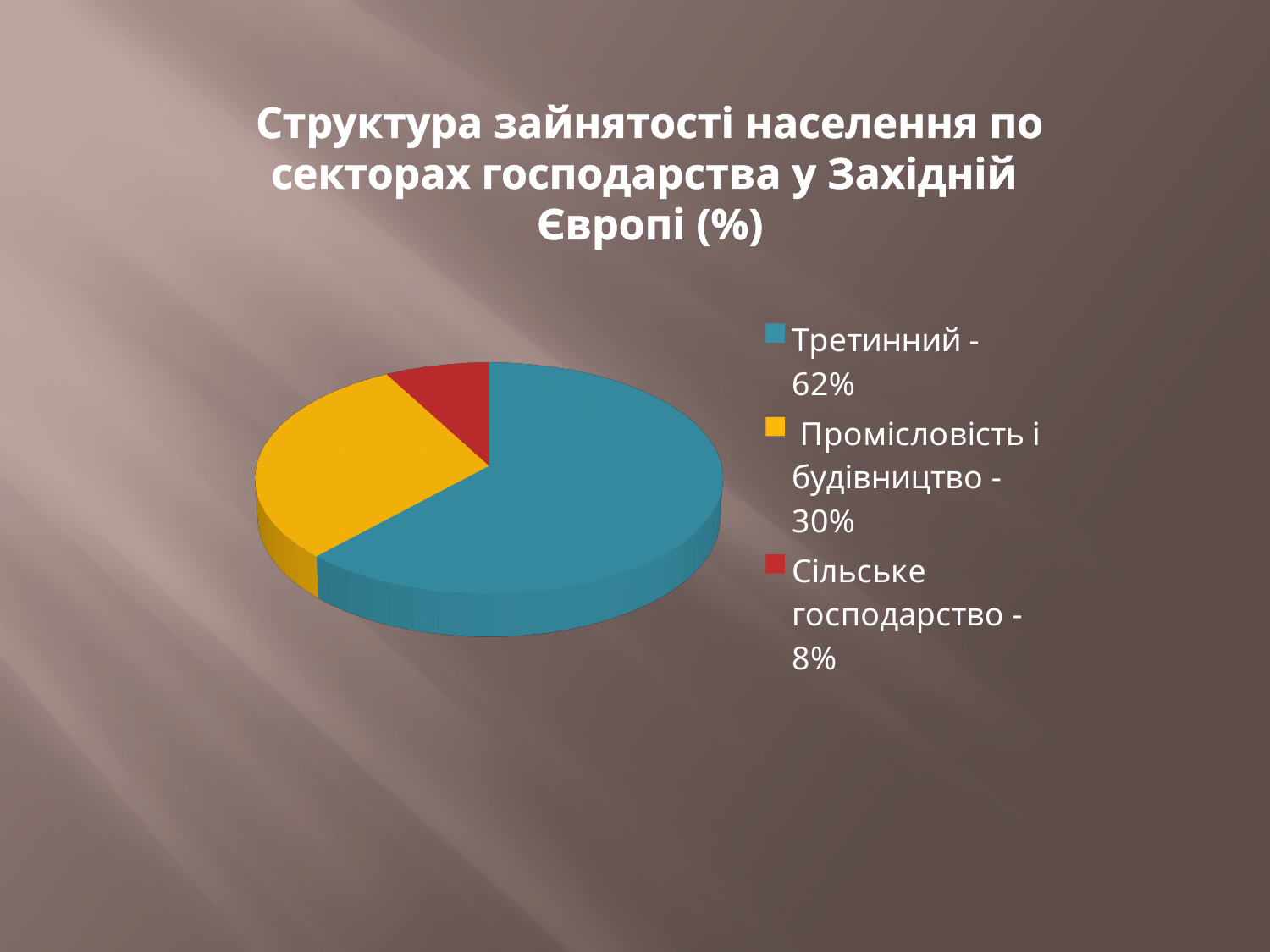
Which sector has the largest share of the pie? Третинний What kind of chart is shown on the slide? pie chart What is the value for Третинний? 62% What is the value for Сільське господарство? 8% Which is larger, the share of Промісловість і будівництво or the share of Сільське господарство? Промісловість і будівництво How many slices does the pie chart have? 3 What is the difference between the shares of Промісловість і будівництво and Сільське господарство? 22% What is the value for Промісловість і будівництво? 30% What is the difference between the shares of Третинний and Промісловість і будівництво? 32% Which sector has the smallest share of the pie? Сільське господарство What colour is the slice for Третинний? blue What is the title of the chart? Структура зайнятості населення по секторах господарства у Західній Європі (%)